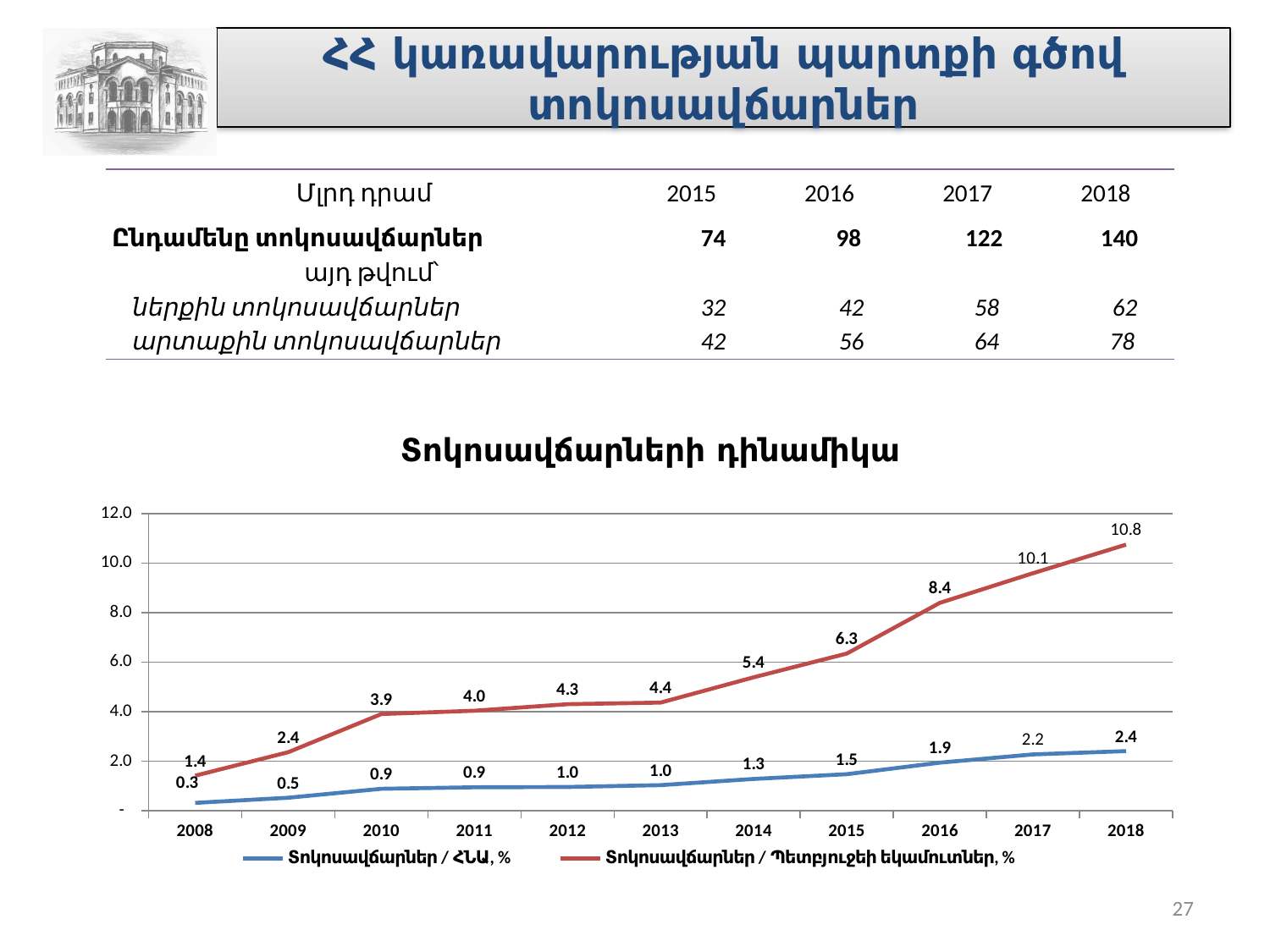
What is the difference between the "Տոկոսավճարներ / Պետբյուջեի եկամուտներ, %" values for 2017 and 2016? 1.7 What type of chart is shown under the title "Տոկոսավճարների դինամիկա"? line chart Which series has the larger value in 2015: "Տոկոսավճարներ / ՀՆԱ, %" or "Տոկոսավճարներ / Պետբյուջեի եկամուտներ, %"? Տոկոսավճարներ / Պետբյուջեի եկամուտներ, % What colour is the line for "Տոկոսավճարներ / ՀՆԱ, %"? blue In which year is "Տոկոսավճարներ / Պետբյուջեի եկամուտներ, %" highest? 2018 How many series does the legend of the chart list? 2 What is the value of "Տոկոսավճարներ / ՀՆԱ, %" in 2014? 1.3 What is the value of "Տոկոսավճարներ / Պետբյուջեի եկամուտներ, %" in 2018? 10.8 Does "Տոկոսավճարներ / Պետբյուջեի եկամուտներ, %" rise or fall from 2008 to 2018? rise In which year is "Տոկոսավճարներ / ՀՆԱ, %" lowest? 2008 How many years are shown on the x axis of the chart? 11 What is the value of "Տոկոսավճարներ / Պետբյուջեի եկամուտներ, %" in 2010? 3.9